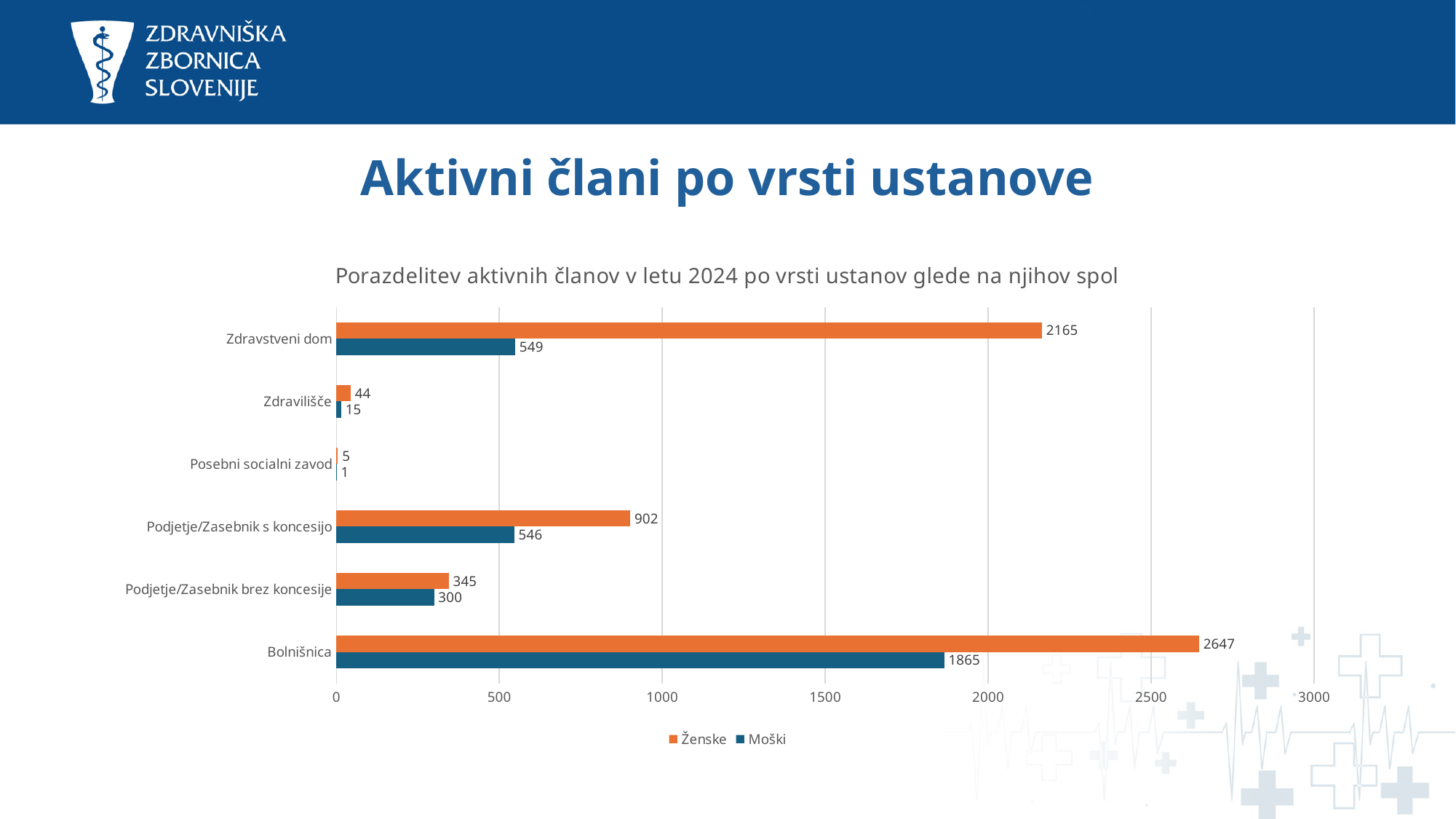
How many series does the legend list? 2 How many categories are shown on the chart? 6 Which category has the lowest Moški value? Posebni socialni zavod What is the chart's title? Porazdelitev aktivnih članov v letu 2024 po vrsti ustanov glede na njihov spol What is the value for Moški in the Bolnišnica category? 1865 Is the Moški value for Zdravstveni dom greater or less than 1000? less What is the value for Ženske in the Zdravstveni dom category? 2165 Which is larger, the Ženske value for Podjetje/Zasebnik s koncesijo or the Ženske value for Podjetje/Zasebnik brez koncesije? Podjetje/Zasebnik s koncesijo Which category has the highest Ženske value? Bolnišnica What is the difference between the Ženske and Moški values for Bolnišnica? 782 What is the value for Moški in the Podjetje/Zasebnik s koncesijo category? 546 What kind of chart is shown on the slide? bar chart